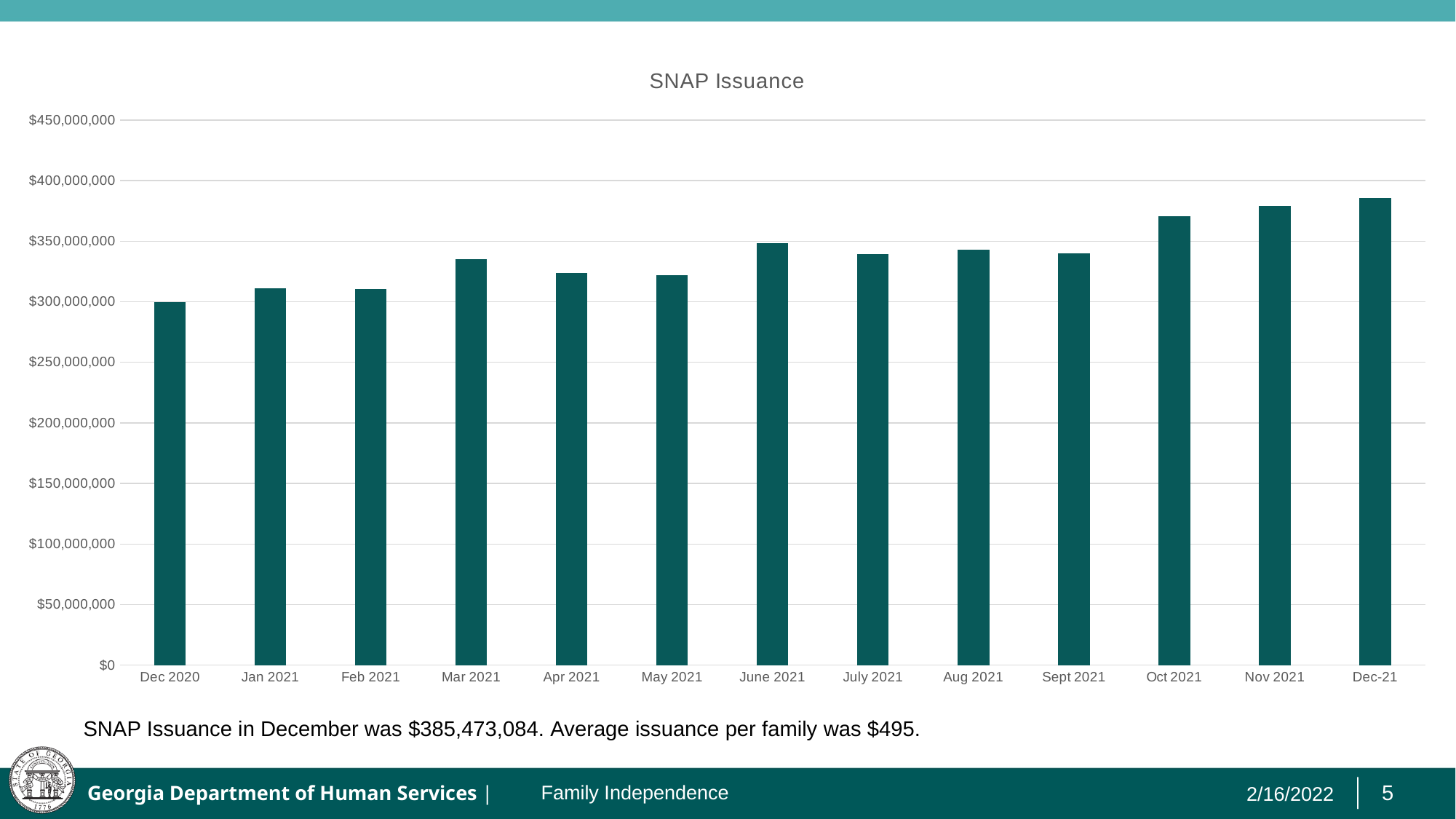
Is the SNAP issuance for Mar 2021 greater or less than $350,000,000? less Which month has the larger SNAP issuance, June 2021 or July 2021? June 2021 What is the title of the chart? SNAP Issuance Is the SNAP issuance for Jan 2021 greater or less than $300,000,000? greater Which month has the larger SNAP issuance, Mar 2021 or Apr 2021? Mar 2021 Which month has the highest SNAP issuance? Dec-21 How many months are plotted on the x axis of the chart? 13 What kind of chart is shown on the slide? Bar chart Is the SNAP issuance for Oct 2021 greater or less than $350,000,000? greater Overall, does SNAP issuance rise or fall from Dec 2020 to Dec-21? Rise What was the SNAP issuance for Dec-21, as stated on the slide? $385,473,084 Which month has the lowest SNAP issuance? Dec 2020